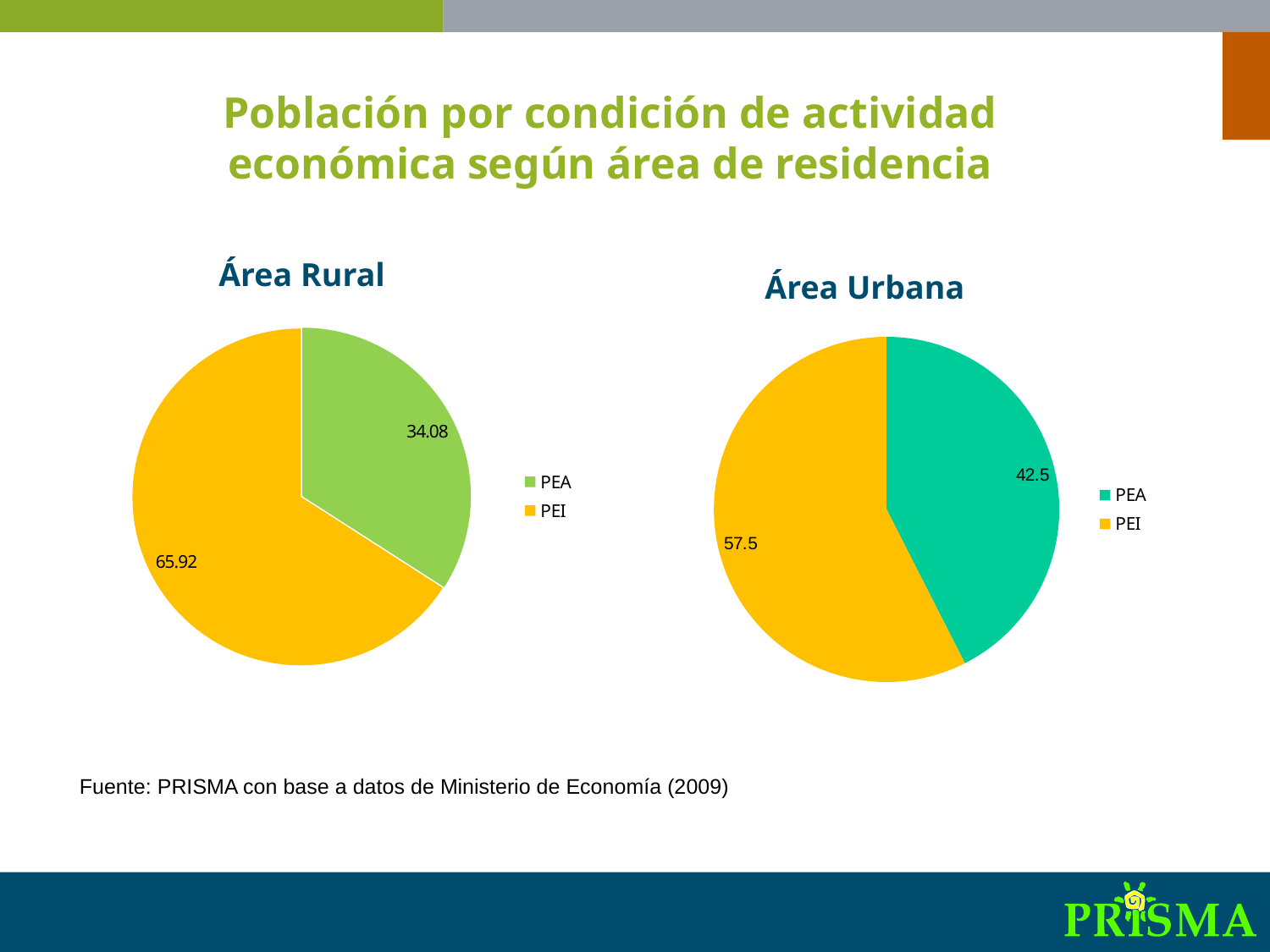
What kind of chart is the Área Rural chart? Pie chart How many slices does the Área Urbana chart have? 2 Which is larger: the PEA value in the Área Rural chart or the PEA value in the Área Urbana chart? Área Urbana In the Área Urbana chart, what is the value for PEI? 57.5 In the Área Urbana chart, what is the value for PEA? 42.5 In the Área Rural chart, what is the difference between the PEI and PEA values? 31.84 In the Área Rural chart, what is the value for PEI? 65.92 In the Área Rural chart, which category has the largest slice? PEI How many entries does the legend of the Área Rural chart list? 2 In the Área Urbana chart, which category has the smallest slice? PEA In the Área Urbana chart, what is the difference between the PEI and PEA values? 15 In the Área Rural chart, what is the value for PEA? 34.08